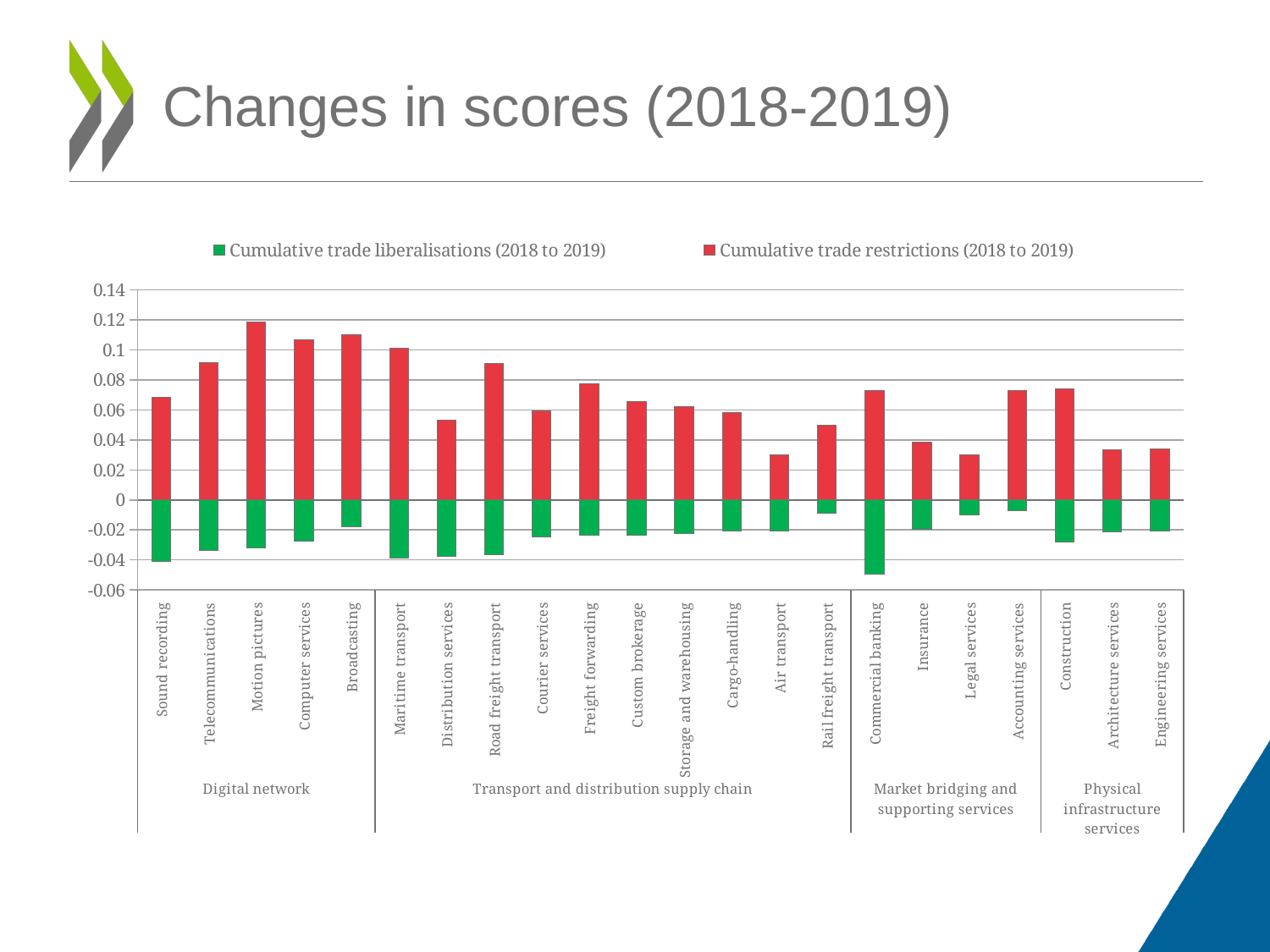
What kind of chart is shown on the slide? bar chart Is the cumulative trade restrictions value for Road freight transport greater or less than 0.08? greater How many sector groups are the categories divided into along the x axis? 4 Is the cumulative trade restrictions value for Sound recording greater or less than 0.08? less Which category has the highest cumulative trade restrictions (2018 to 2019)? Motion pictures Is the cumulative trade restrictions value for Motion pictures greater or less than 0.1? greater Which category has the largest (most negative) cumulative trade liberalisations (2018 to 2019)? Commercial banking How many service categories are plotted along the x axis? 22 Which has the larger cumulative trade restrictions value, Telecommunications or Sound recording? Telecommunications How many series does the legend list? 2 What colour represents cumulative trade liberalisations (2018 to 2019)? green